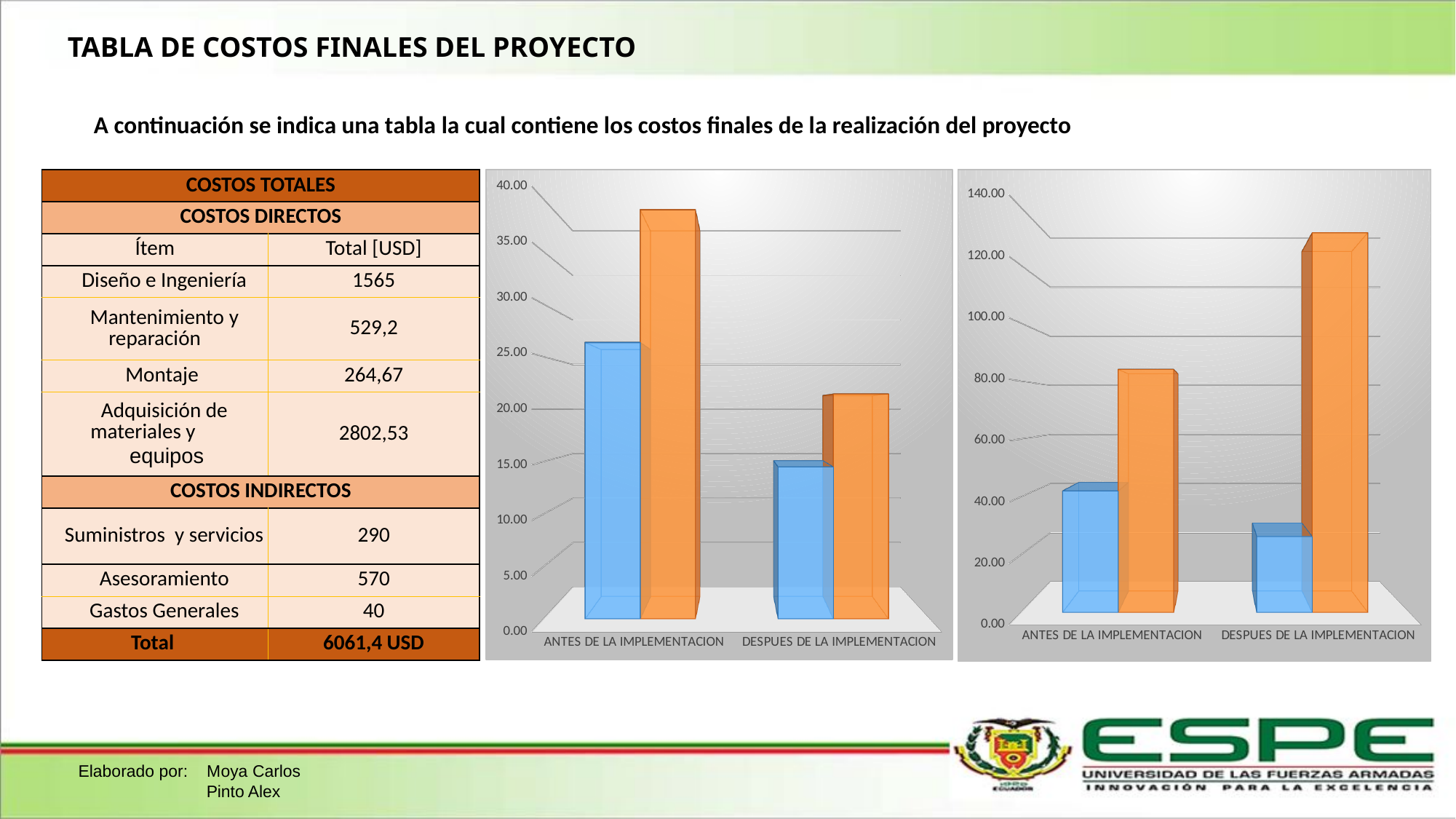
In the right chart, is the orange bar for DESPUES DE LA IMPLEMENTACION greater or less than 100.00? greater In the left chart, is the blue bar for DESPUES DE LA IMPLEMENTACION greater or less than 20.00? less What kind of chart is the left chart on the slide? bar chart How many categories are shown on the x axis of the right chart? 2 In the right chart, is the orange bar for ANTES DE LA IMPLEMENTACION greater or less than 60.00? greater In the right chart, do the blue bars rise or fall from ANTES DE LA IMPLEMENTACION to DESPUES DE LA IMPLEMENTACION? fall In the right chart, which category has the taller orange bar, ANTES DE LA IMPLEMENTACION or DESPUES DE LA IMPLEMENTACION? DESPUES DE LA IMPLEMENTACION In the left chart, which category has the taller orange bar, ANTES DE LA IMPLEMENTACION or DESPUES DE LA IMPLEMENTACION? ANTES DE LA IMPLEMENTACION In the left chart, which bar is the tallest overall? the orange bar for ANTES DE LA IMPLEMENTACION